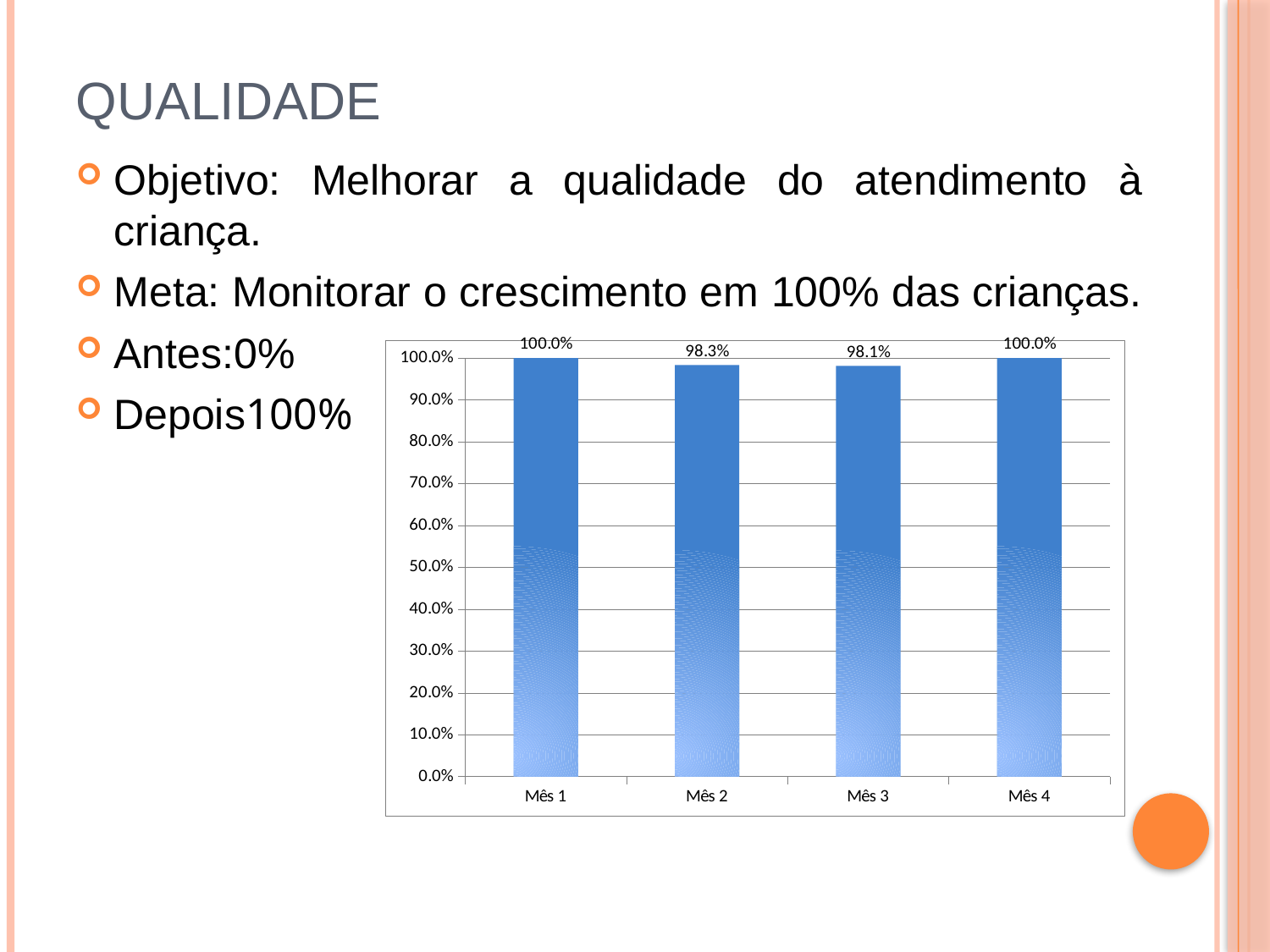
Is the value for Mês 3 greater or less than 90.0%? greater How many months are shown on the x axis? 4 Do the values fall or rise from Mês 1 to Mês 3? fall What is the value for Mês 3? 98.1% Which month has the lowest value? Mês 3 What is the difference between the values for Mês 4 and Mês 3? 1.9% What is the difference between the values for Mês 1 and Mês 2? 1.7% Which is larger, the value for Mês 2 or the value for Mês 3? Mês 2 What is the value for Mês 1? 100.0% What is the value for Mês 4? 100.0% What is the value for Mês 2? 98.3% What kind of chart is shown on the slide? bar chart